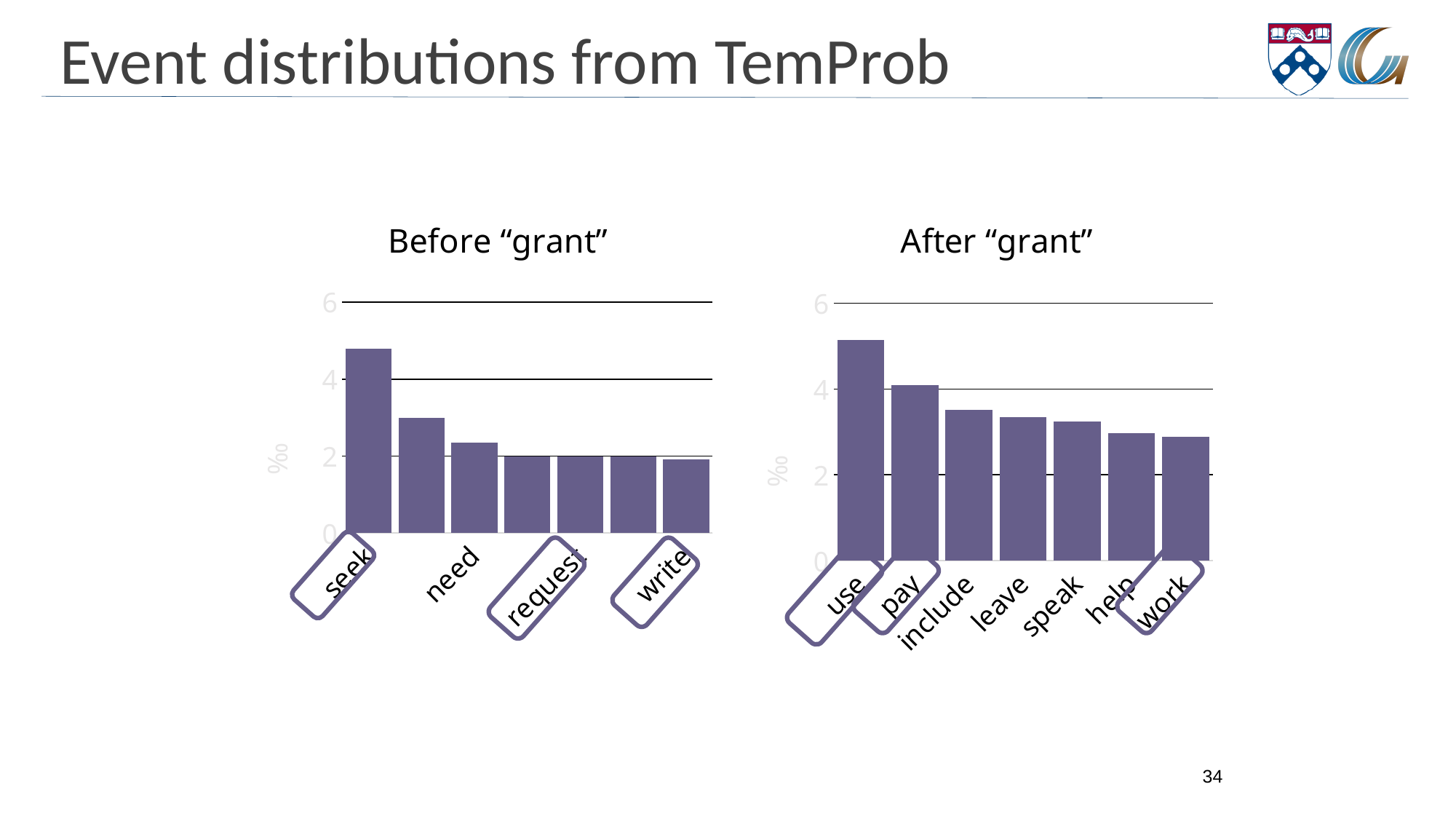
What kind of chart is the "Before "grant"" chart? bar chart In the "Before "grant"" chart, which is larger, the value for seek or the value for need? seek In the "After "grant"" chart, is the value for use greater or less than 4? greater In the "After "grant"" chart, is the value for work greater or less than 4? less In the "After "grant"" chart, which category has the highest value? use In the "Before "grant"" chart, which category has the highest value? seek In the "After "grant"" chart, which is larger, the value for use or the value for pay? use What unit is shown on the y axis of the "Before "grant"" chart? ‰ In the "Before "grant"" chart, is the value for seek greater or less than 4? greater In the "After "grant"" chart, how many bars are plotted? 7 In the "After "grant"" chart, do the values rise or fall from left to right along the x axis? fall